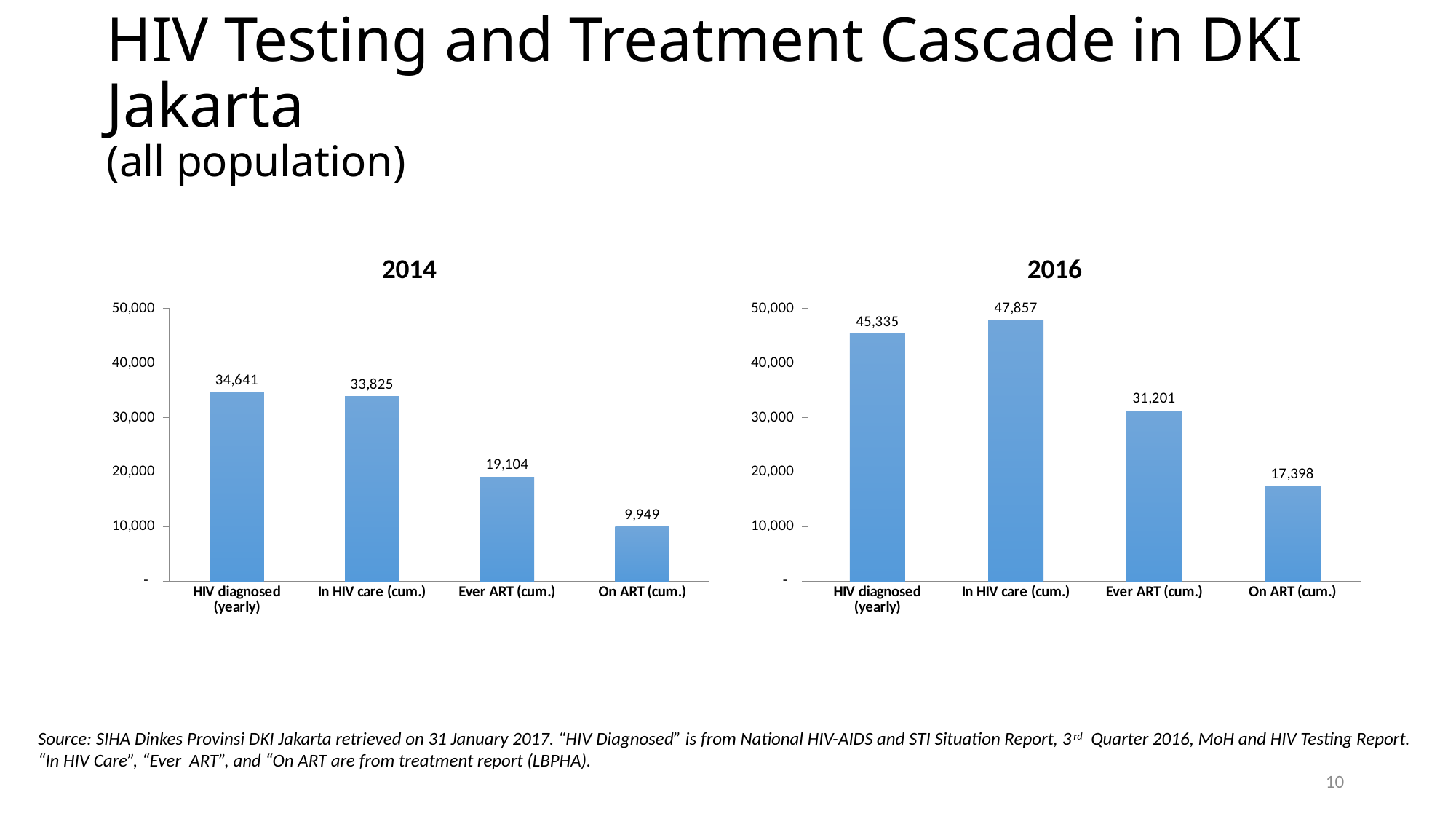
What kind of chart is the 2016 chart? bar chart In the 2016 chart, what is the value for On ART (cum.)? 17,398 In the 2014 chart, what is the value for HIV diagnosed (yearly)? 34,641 How many categories are shown in the 2014 chart? 4 In the 2014 chart, what is the value for Ever ART (cum.)? 19,104 Which is larger: On ART (cum.) in the 2014 chart or On ART (cum.) in the 2016 chart? On ART (cum.) in the 2016 chart In the 2014 chart, which category has the lowest value? On ART (cum.) In the 2016 chart, which category has the highest value? In HIV care (cum.) In the 2016 chart, do the values rise or fall from In HIV care (cum.) to On ART (cum.)? fall In the 2014 chart, what is the difference between Ever ART (cum.) and On ART (cum.)? 9,155 In the 2016 chart, what is the difference between In HIV care (cum.) and Ever ART (cum.)? 16,656 In the 2016 chart, is the value for Ever ART (cum.) greater or less than 40,000? less